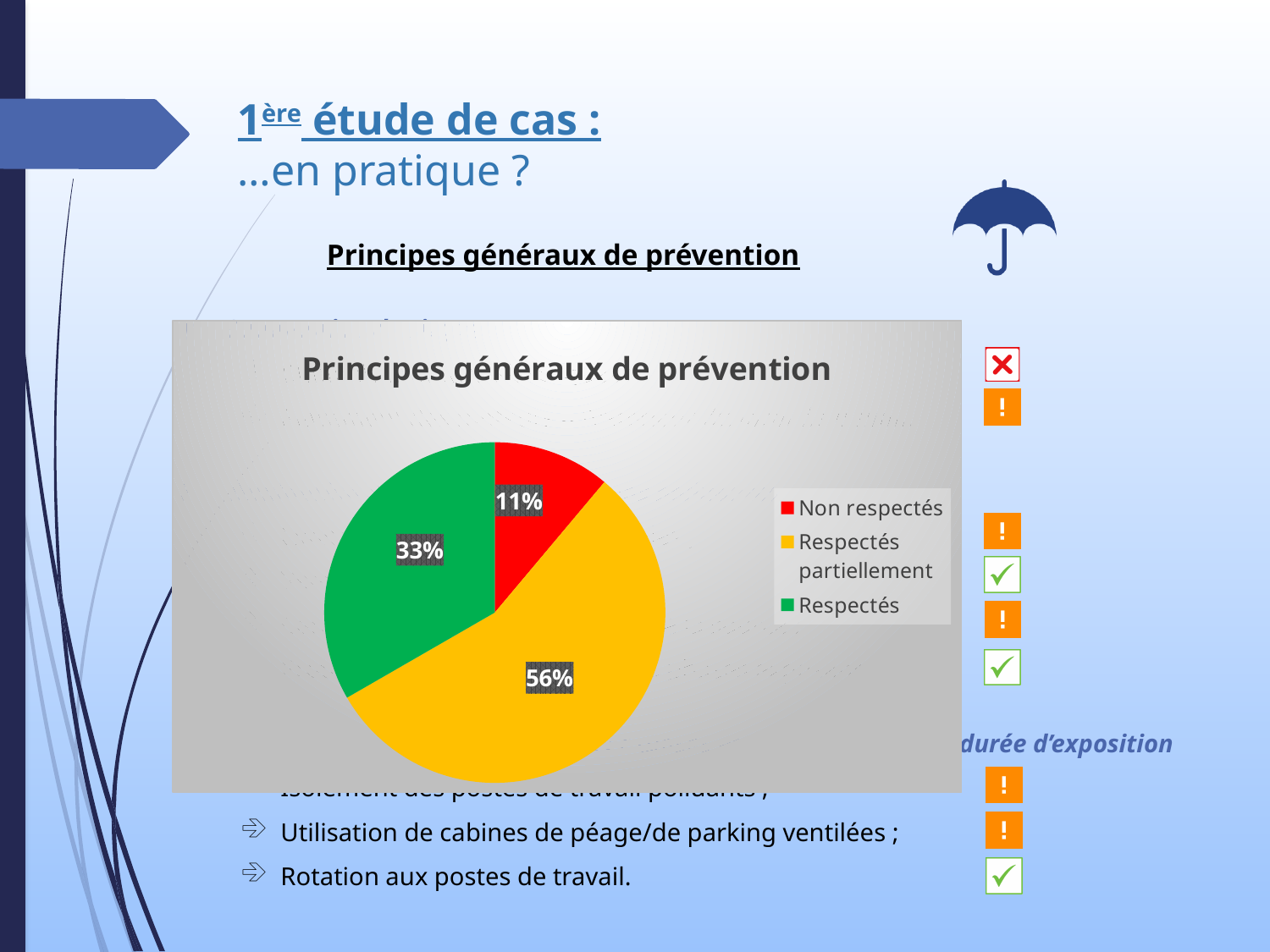
What is the difference in percentage points between "Respectés" and "Non respectés"? 22% What share of the pie is labelled "Respectés"? 33% Which is larger, the share for "Respectés" or the share for "Non respectés"? Respectés What share of the pie is labelled "Respectés partiellement"? 56% What kind of chart is shown on the slide? pie chart How many categories does the legend list? 3 Which category has the largest slice of the pie? Respectés partiellement What is the title of the chart? Principes généraux de prévention Which category has the smallest slice of the pie? Non respectés What share of the pie is labelled "Non respectés"? 11% What colour is the slice for "Non respectés"? red What is the difference in percentage points between "Respectés partiellement" and "Respectés"? 23%